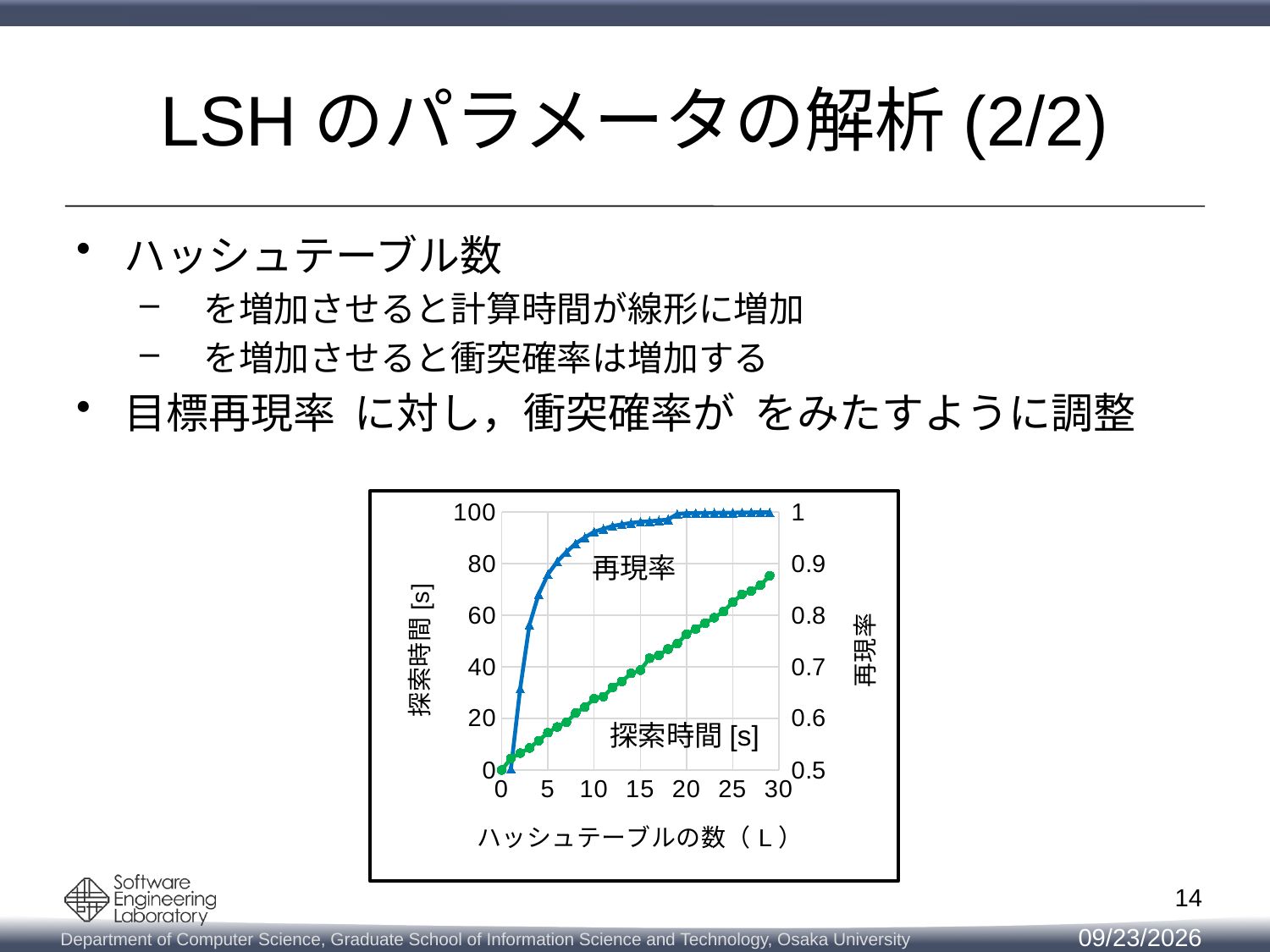
What is the label of the x axis of the chart? ハッシュテーブルの数（L） Is the 探索時間 [s] value at L = 10 greater or less than 40? less Does the 探索時間 [s] series rise or fall as the number of hash tables L increases? rise Does the 再現率 series rise or fall as the number of hash tables L increases? rise Is the 探索時間 [s] value at L = 5 greater or less than 20? less Is the 再現率 value at L = 20 greater or less than 0.9? greater How many data series are plotted in the chart? 2 What kind of chart is shown on the slide? line chart What is the label of the left vertical axis of the chart? 探索時間 [s]